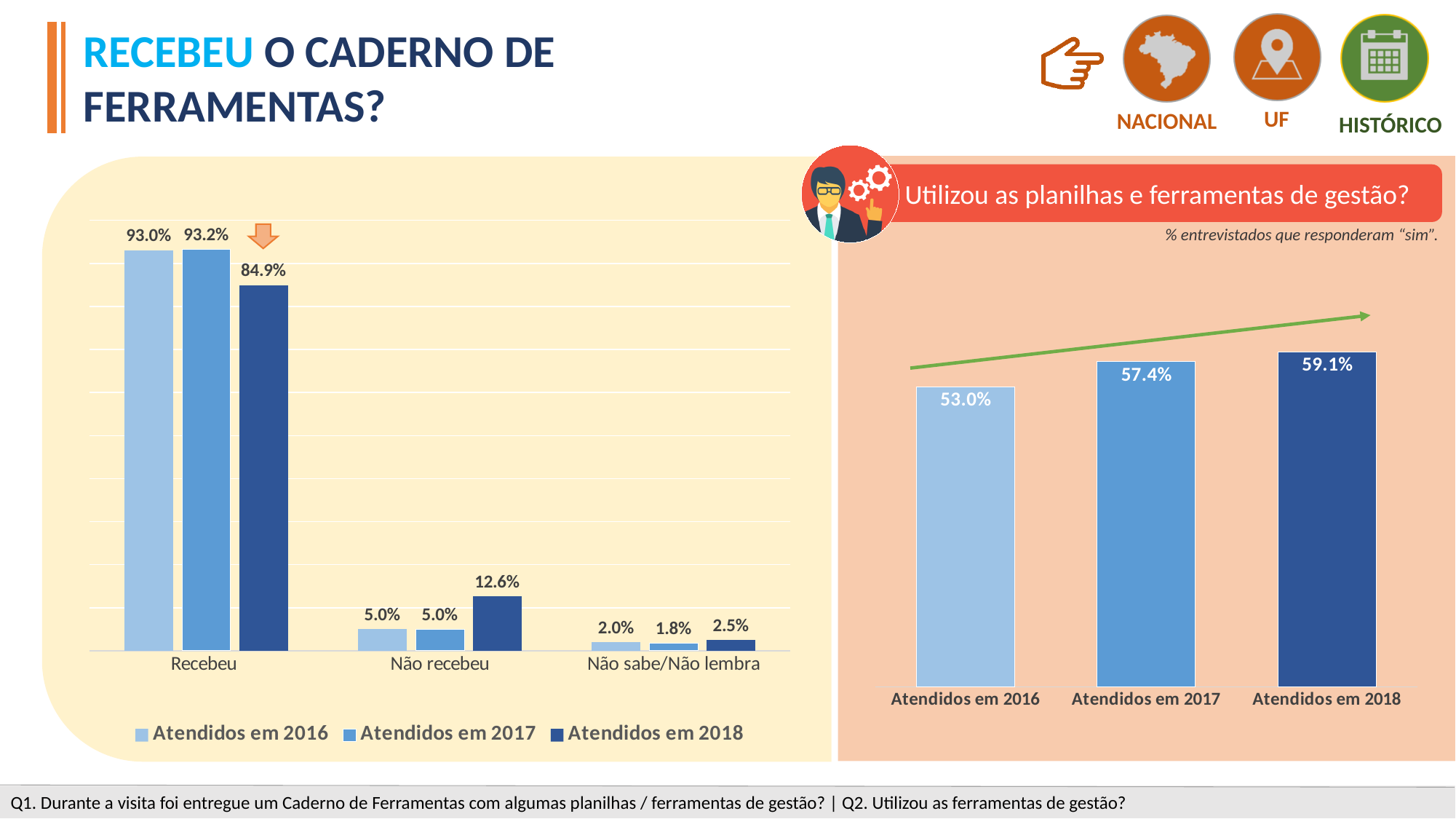
In the right chart (Utilizou as planilhas e ferramentas de gestão?), what is the value for Atendidos em 2017? 57.4% What kind of chart is the right chart (Utilizou as planilhas e ferramentas de gestão?)? bar chart In the left chart (Recebeu o Caderno de Ferramentas?), how many categories are shown on the x axis? 3 In the left chart (Recebeu o Caderno de Ferramentas?), what is the value for Não recebeu for Atendidos em 2018? 12.6% In the right chart (Utilizou as planilhas e ferramentas de gestão?), do the values rise or fall from Atendidos em 2016 to Atendidos em 2018? rise In the right chart (Utilizou as planilhas e ferramentas de gestão?), which category has the lowest value? Atendidos em 2016 In the left chart (Recebeu o Caderno de Ferramentas?), what is the value for Não sabe/Não lembra for Atendidos em 2017? 1.8% In the left chart (Recebeu o Caderno de Ferramentas?), how many series does the legend list? 3 In the left chart (Recebeu o Caderno de Ferramentas?), what is the value for Recebeu for Atendidos em 2018? 84.9% In the left chart (Recebeu o Caderno de Ferramentas?), what is the difference between the Recebeu values for Atendidos em 2017 and Atendidos em 2018? 8.3% In the right chart (Utilizou as planilhas e ferramentas de gestão?), what is the difference between Atendidos em 2018 and Atendidos em 2016? 6.1% In the left chart (Recebeu o Caderno de Ferramentas?), which series has the highest value for Recebeu? Atendidos em 2017